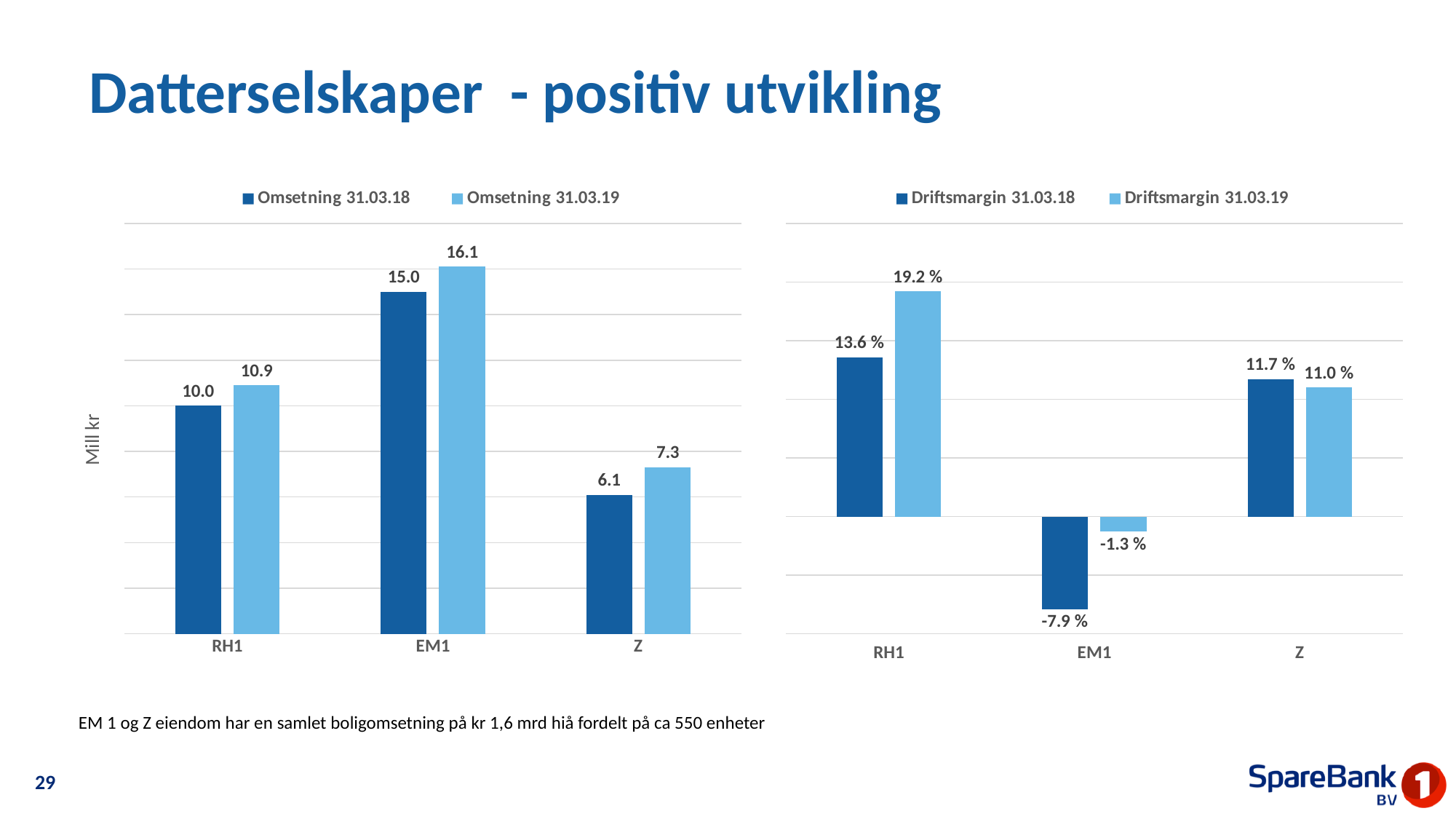
In the left chart (Omsetning), which category has the highest Omsetning 31.03.19 value? EM1 What kind of chart is the left chart (Omsetning)? bar chart In the left chart (Omsetning), what is the Omsetning 31.03.19 value for EM1? 16.1 In the right chart (Driftsmargin), what is the Driftsmargin 31.03.19 value for RH1? 19.2 % In the right chart (Driftsmargin), how many categories are shown on the x axis? 3 In the left chart (Omsetning), what is the Omsetning 31.03.18 value for Z? 6.1 In the right chart (Driftsmargin), what is the Driftsmargin 31.03.18 value for EM1? -7.9 % In the right chart (Driftsmargin), is the Driftsmargin 31.03.18 value for Z larger or smaller than the Driftsmargin 31.03.19 value for Z? larger In the right chart (Driftsmargin), which category has the lowest Driftsmargin 31.03.19 value? EM1 In the left chart (Omsetning), how many series does the legend list? 2 In the left chart (Omsetning), which category has the lowest Omsetning 31.03.18 value? Z In the left chart (Omsetning), what is the difference between Omsetning 31.03.19 and Omsetning 31.03.18 for RH1? 0.9